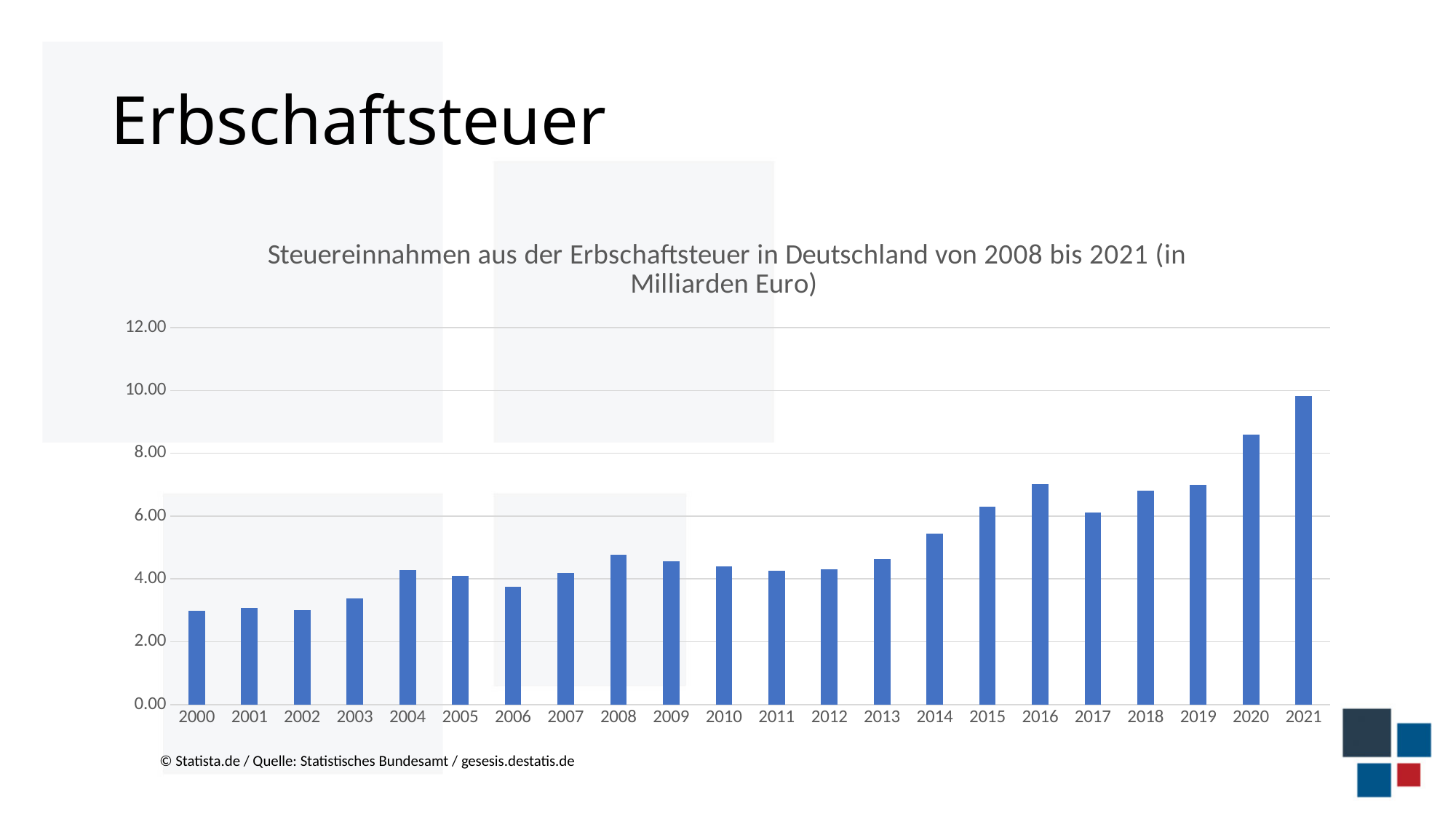
Which year has the larger value, 2003 or 2004? 2004 Which year has the highest value in the chart? 2021 What kind of chart is shown on the slide? bar chart Which year has the larger value, 2016 or 2017? 2016 How many years are plotted on the x axis of the chart? 22 Is the value for 2016 greater or less than 6.00? greater What is the title of the chart? Steuereinnahmen aus der Erbschaftsteuer in Deutschland von 2008 bis 2021 (in Milliarden Euro) Is the value for 2021 greater or less than 8.00? greater Do the values generally rise or fall from 2000 to 2021? rise Is the value for 2014 greater or less than 6.00? less